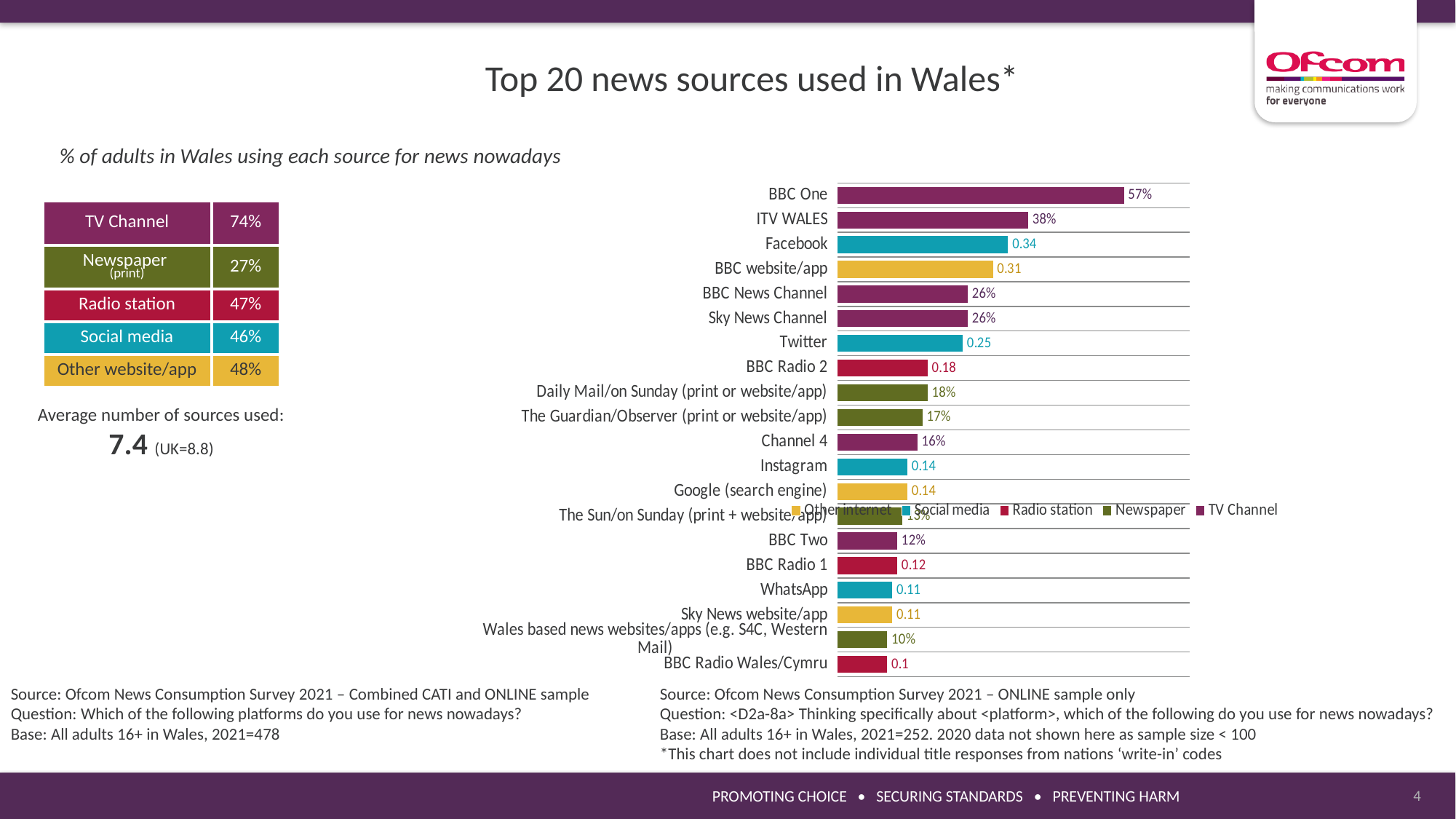
What is the value shown for Facebook? 0.34 How many series does the legend list? 5 What is the value for ITV WALES? 38% What is the value shown for Twitter? 0.25 What is the difference between the values for BBC One and ITV WALES? 19% What is the value for BBC One? 57% How many news sources are plotted in the chart? 20 What type of chart is used to show the top 20 news sources? Bar chart Which news source has the highest value in the chart? BBC One Which has a larger value, Daily Mail/on Sunday (print or website/app) or Channel 4? Daily Mail/on Sunday (print or website/app) Which legend entry is shown in yellow? Other internet